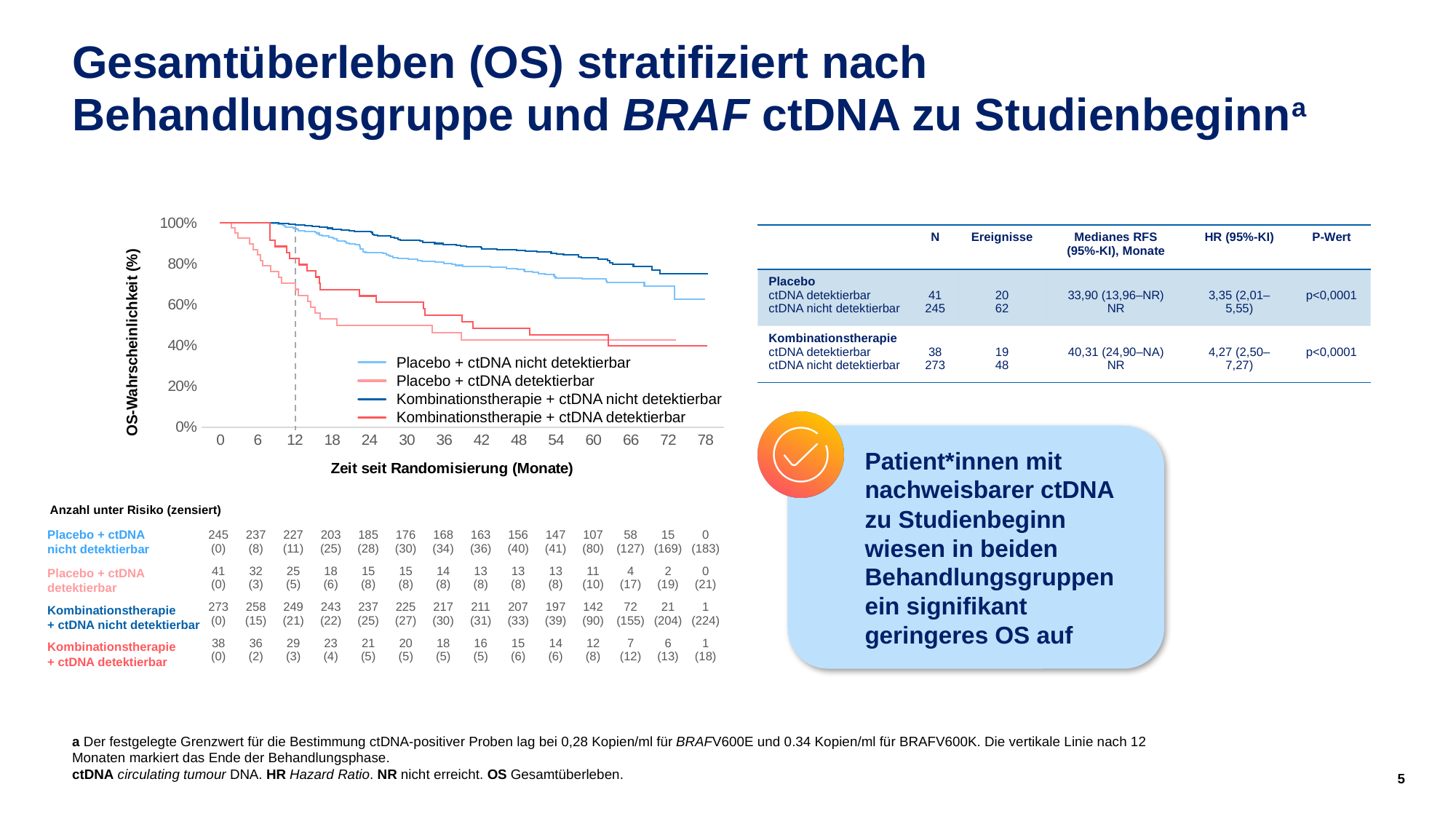
How many series does the chart legend list? 4 What is the title of the y axis of the chart? OS-Wahrscheinlichkeit (%) At 36 months, is the value for Placebo + ctDNA detektierbar greater or less than 60%? less What kind of chart is shown on the slide? Line chart (Kaplan-Meier survival curve) At 78 months, which curve is higher: Kombinationstherapie + ctDNA nicht detektierbar or Kombinationstherapie + ctDNA detektierbar? Kombinationstherapie + ctDNA nicht detektierbar Which group has the highest number at risk at 0 months in the number-at-risk table? Kombinationstherapie + ctDNA nicht detektierbar Do the survival curves rise or fall as time since randomisation increases? Fall What is the difference in the number at risk at 0 months between Kombinationstherapie + ctDNA nicht detektierbar and Placebo + ctDNA nicht detektierbar? 28 According to the number-at-risk table, how many patients were at risk in the Placebo + ctDNA nicht detektierbar group at 0 months? 245 At 78 months, is the value for Kombinationstherapie + ctDNA nicht detektierbar greater or less than 60%? greater What is the title of the x axis of the chart? Zeit seit Randomisierung (Monate) According to the number-at-risk table, how many patients were at risk in the Kombinationstherapie + ctDNA detektierbar group at 12 months? 29